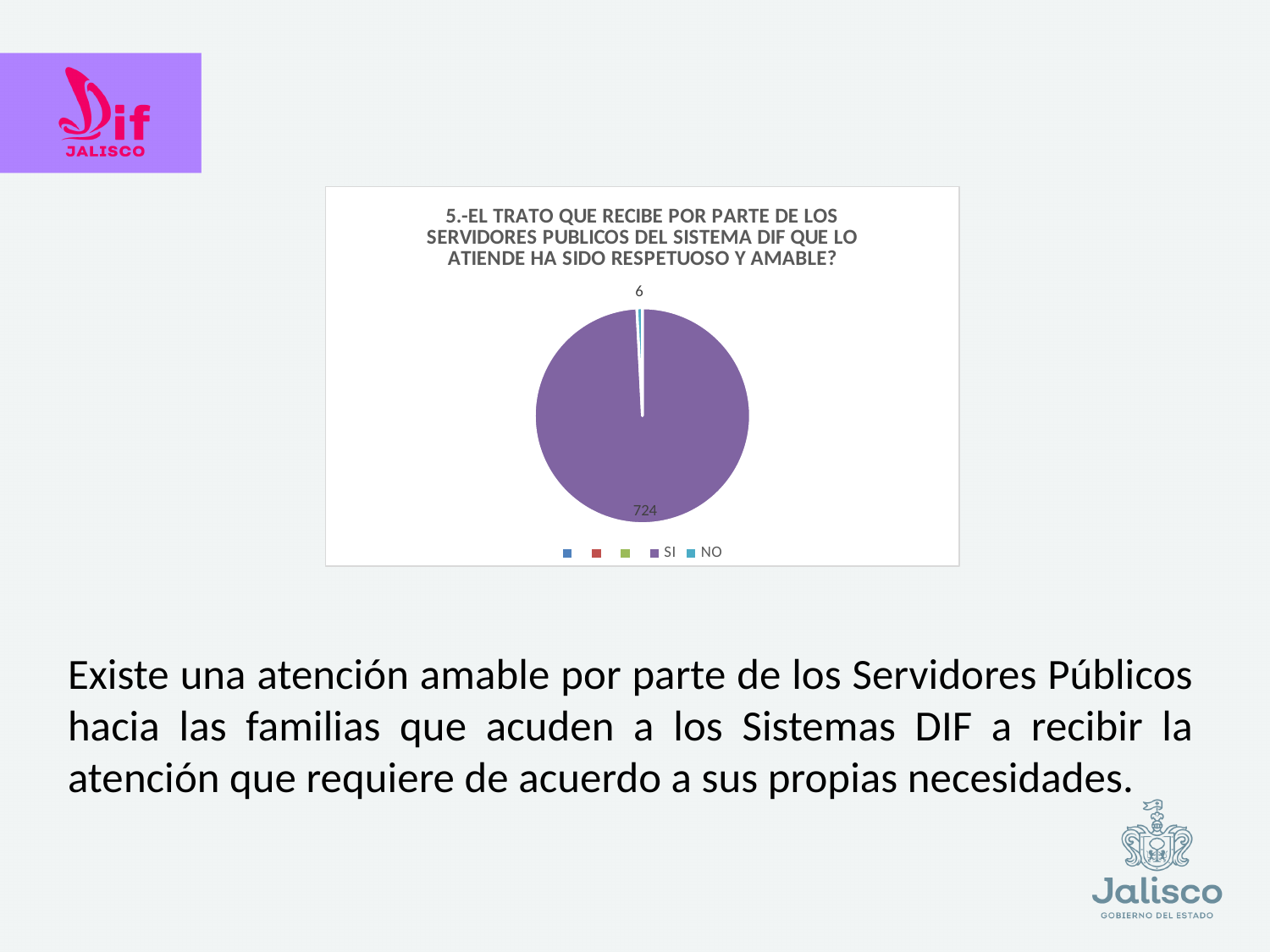
What is the value for NO in the pie chart? 6 What colour is the SI slice in the pie chart? purple What question number does the chart title begin with? 5 Is the value for SI greater or less than 500? greater Which category has the largest slice in the pie chart? SI What is the value for SI in the pie chart? 724 What is the total of the SI and NO values shown in the pie chart? 730 What kind of chart is shown on the slide? pie chart Which is larger in the pie chart, SI or NO? SI How many labelled slices does the pie chart have? 2 Which category has the smallest slice in the pie chart? NO What is the difference between the SI and NO values in the pie chart? 718